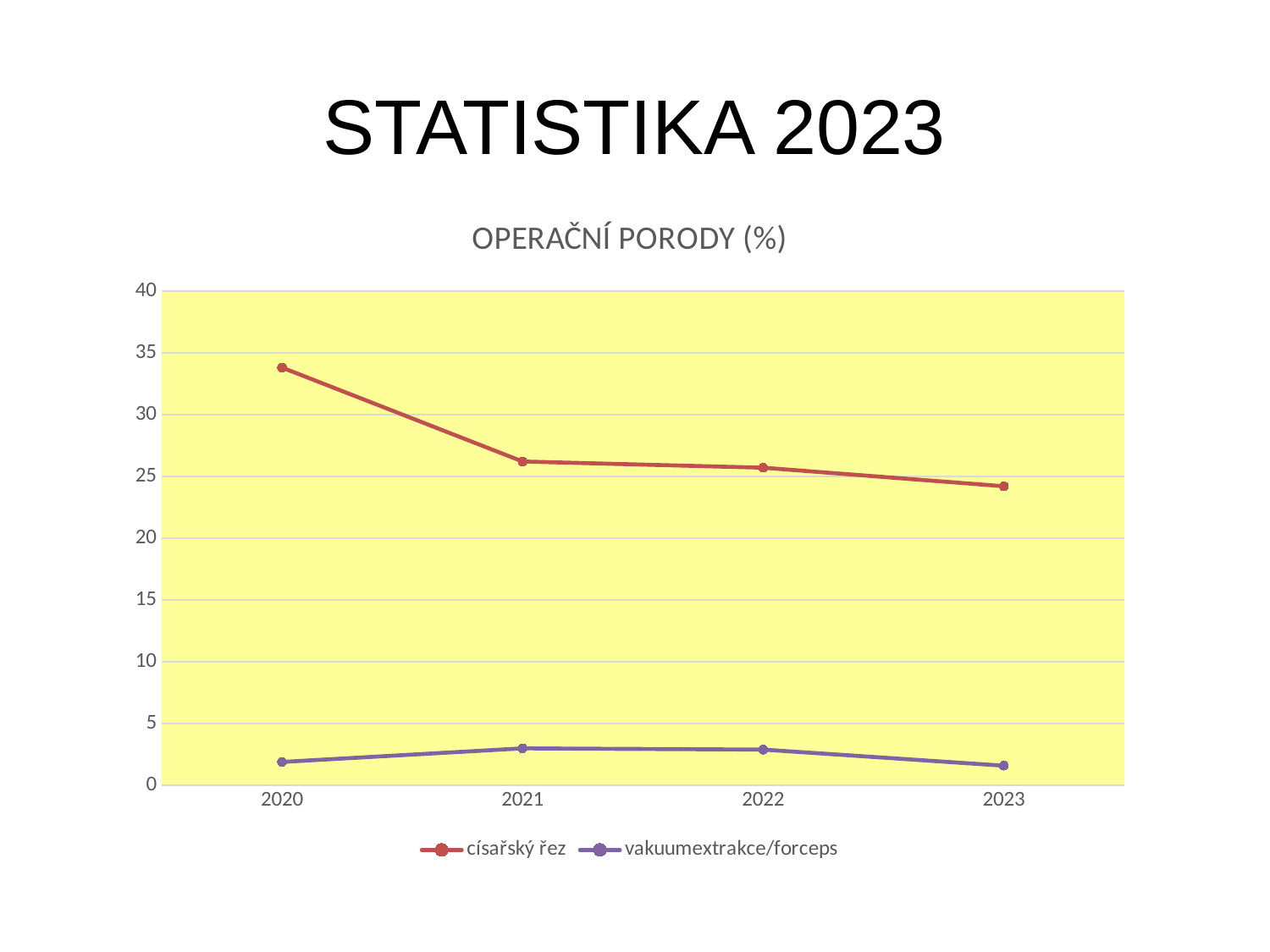
How many years are shown on the x axis? 4 Does the value for císařský řez rise or fall from 2020 to 2023? fall How many series does the legend list? 2 Is the value for císařský řez in 2023 greater or less than 25? less In which year is the value for císařský řez highest? 2020 Is the value for císařský řez in 2020 greater or less than 30? greater In which year is the value for císařský řez lowest? 2023 Which series is drawn in red? císařský řez Is the value for vakuumextrakce/forceps in 2021 greater or less than 5? less Which series has the larger value in 2022, císařský řez or vakuumextrakce/forceps? císařský řez What is the title of the chart? OPERAČNÍ PORODY (%) What kind of chart is shown on the slide? line chart